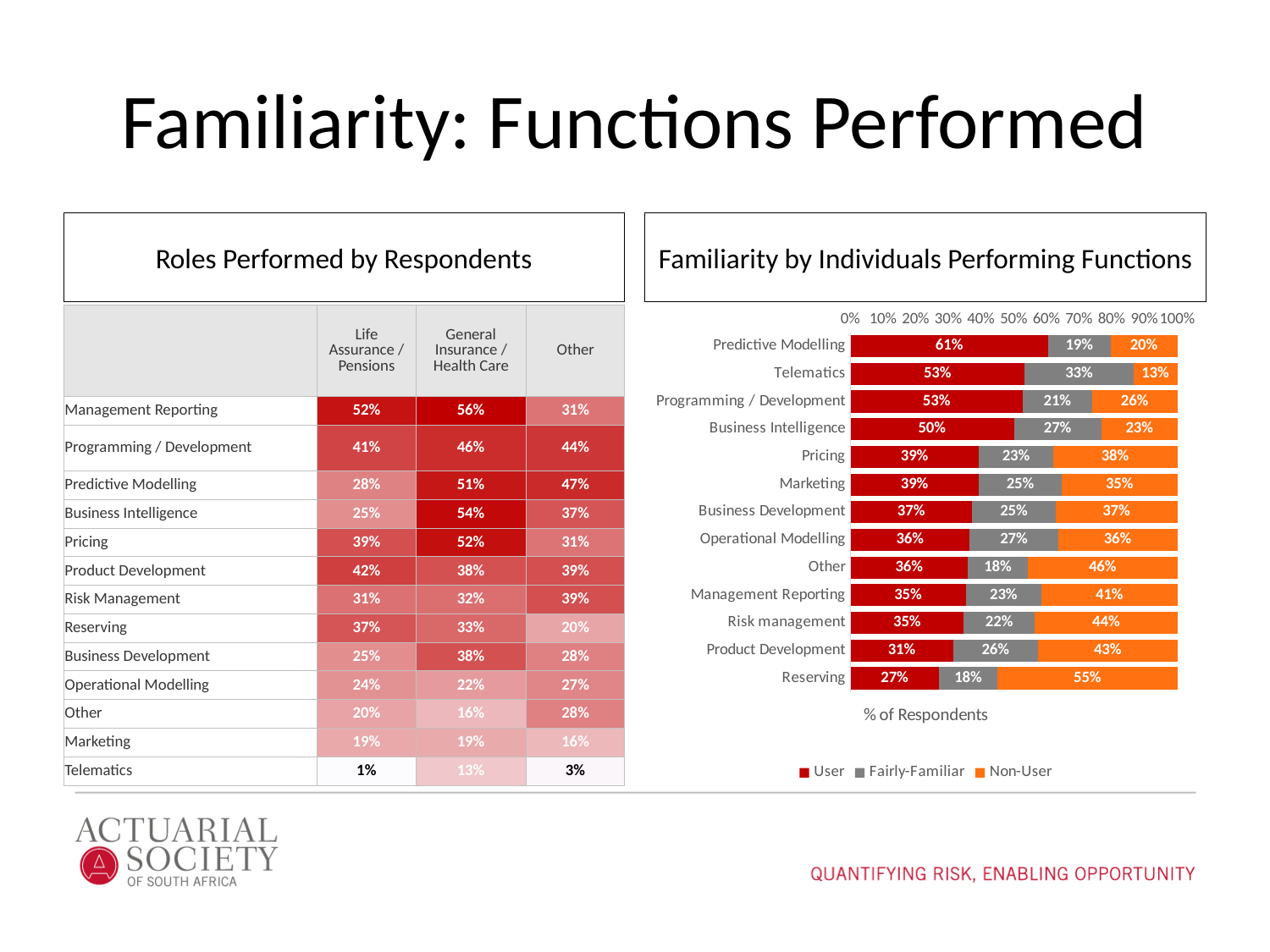
How many series does the legend of the 'Familiarity by Individuals Performing Functions' chart list? 3 In the 'Familiarity by Individuals Performing Functions' chart, what is the Fairly-Familiar value for Telematics? 33% In the 'Familiarity by Individuals Performing Functions' chart, what is the User value for Predictive Modelling? 61% In the 'Familiarity by Individuals Performing Functions' chart, which is larger: the Non-User value for Other or the Non-User value for Pricing? Other How many functions are listed in the 'Familiarity by Individuals Performing Functions' chart? 13 In the 'Familiarity by Individuals Performing Functions' chart, which function has the highest Non-User share? Reserving In the 'Familiarity by Individuals Performing Functions' chart, what colour represents the Non-User series? Orange In the 'Familiarity by Individuals Performing Functions' chart, which function has the lowest User share? Reserving In the 'Familiarity by Individuals Performing Functions' chart, what is the difference between the User values for Predictive Modelling and Reserving? 34% In the 'Familiarity by Individuals Performing Functions' chart, which function has the highest User share? Predictive Modelling In the 'Familiarity by Individuals Performing Functions' chart, what is the Non-User value for Reserving? 55% What kind of chart is 'Familiarity by Individuals Performing Functions'? Stacked bar chart